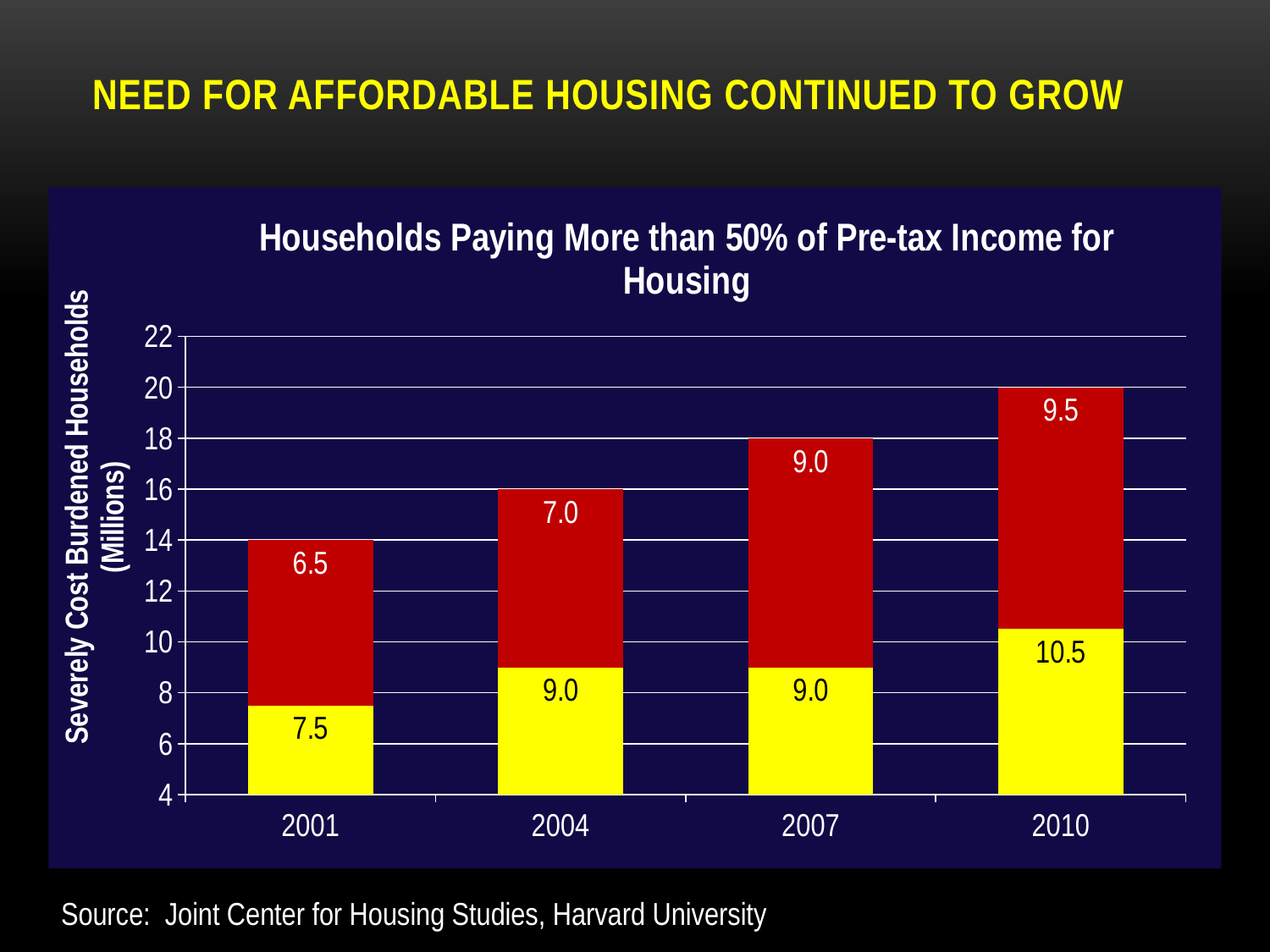
Which year has the shortest stacked bar? 2001 What is the value of the red segment for 2004? 7.0 What is the difference between the yellow segment values for 2010 and 2001? 3.0 Do the stacked bar totals rise or fall from 2001 to 2010? Rise Which year has the tallest stacked bar? 2010 What kind of chart is shown on the slide? Stacked bar chart What is the total of the stacked bar for 2010? 20.0 How many years are shown on the x axis? 4 What is the value of the yellow segment for 2010? 10.5 Which year has the larger red segment, 2004 or 2007? 2007 What is the total of the stacked bar for 2001? 14.0 What is the value of the red segment for 2001? 6.5